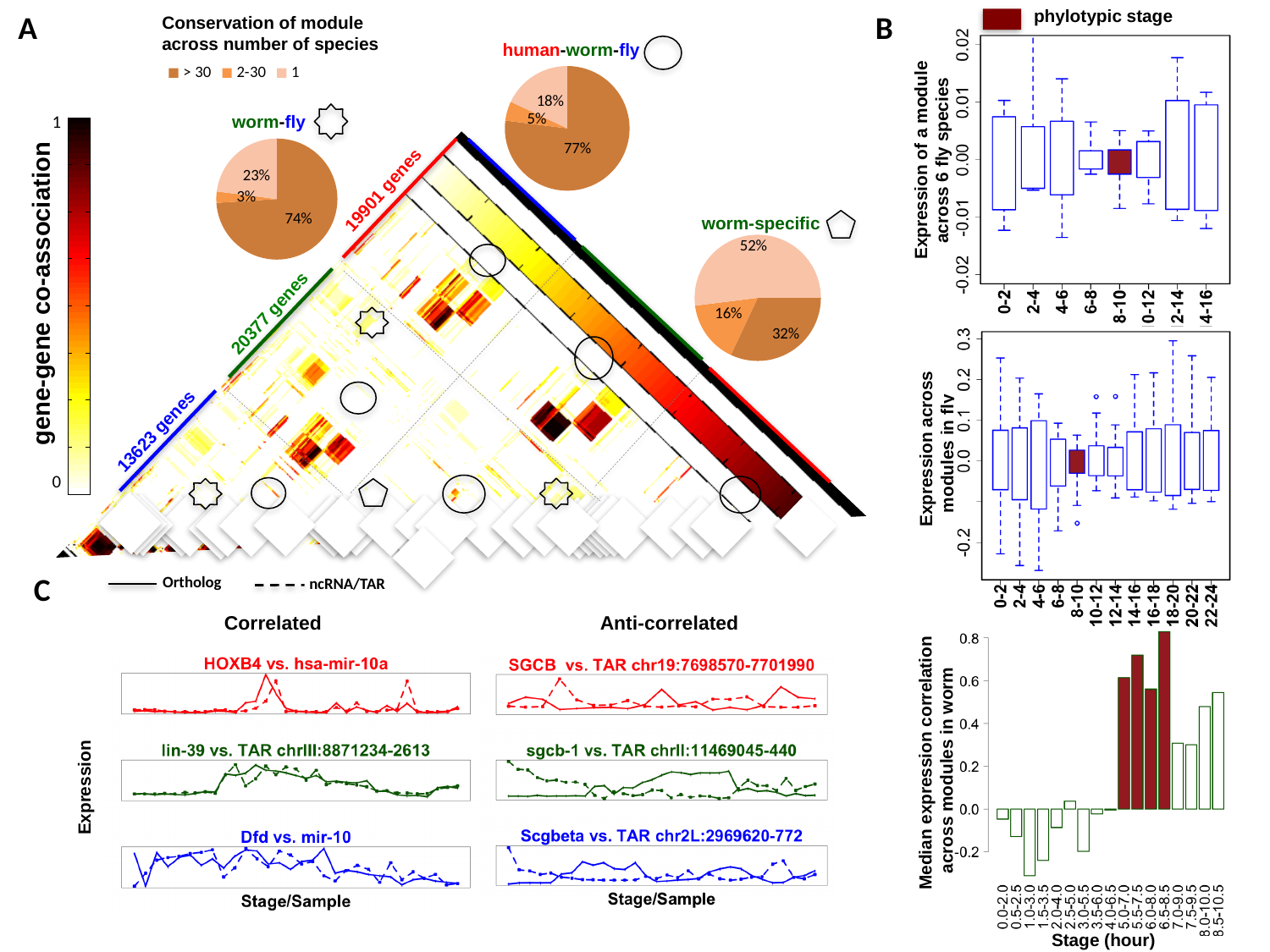
In the 'Median expression correlation across modules in worm' bar chart, which stage has the highest value? 6.5-8.5 In the worm-fly pie chart, what percentage of modules are conserved across more than 30 species? 74% In the 'Median expression correlation across modules in worm' bar chart, which stage has the lowest value? 1.0-3.0 In the human-worm-fly pie chart, what percentage of modules are conserved in only 1 species? 18% In the worm-specific pie chart, what is the share for modules conserved across more than 30 species? 32% In the 'Expression across modules in fly' box plot, how many stage categories are shown on the x axis? 12 Which pie chart has the larger share for modules conserved across more than 30 species, worm-fly or human-worm-fly? human-worm-fly How many conservation categories does the 'Conservation of module across number of species' legend list? 3 In the 'Median expression correlation across modules in worm' bar chart, is the value for stage 6.5-8.5 greater or less than 0.6? greater In the worm-specific pie chart, which conservation category has the largest slice? 1 What kind of chart is the 'Median expression correlation across modules in worm' chart in panel B? bar chart What is the difference between the '> 30' share in the human-worm-fly pie chart and the '> 30' share in the worm-fly pie chart? 3%